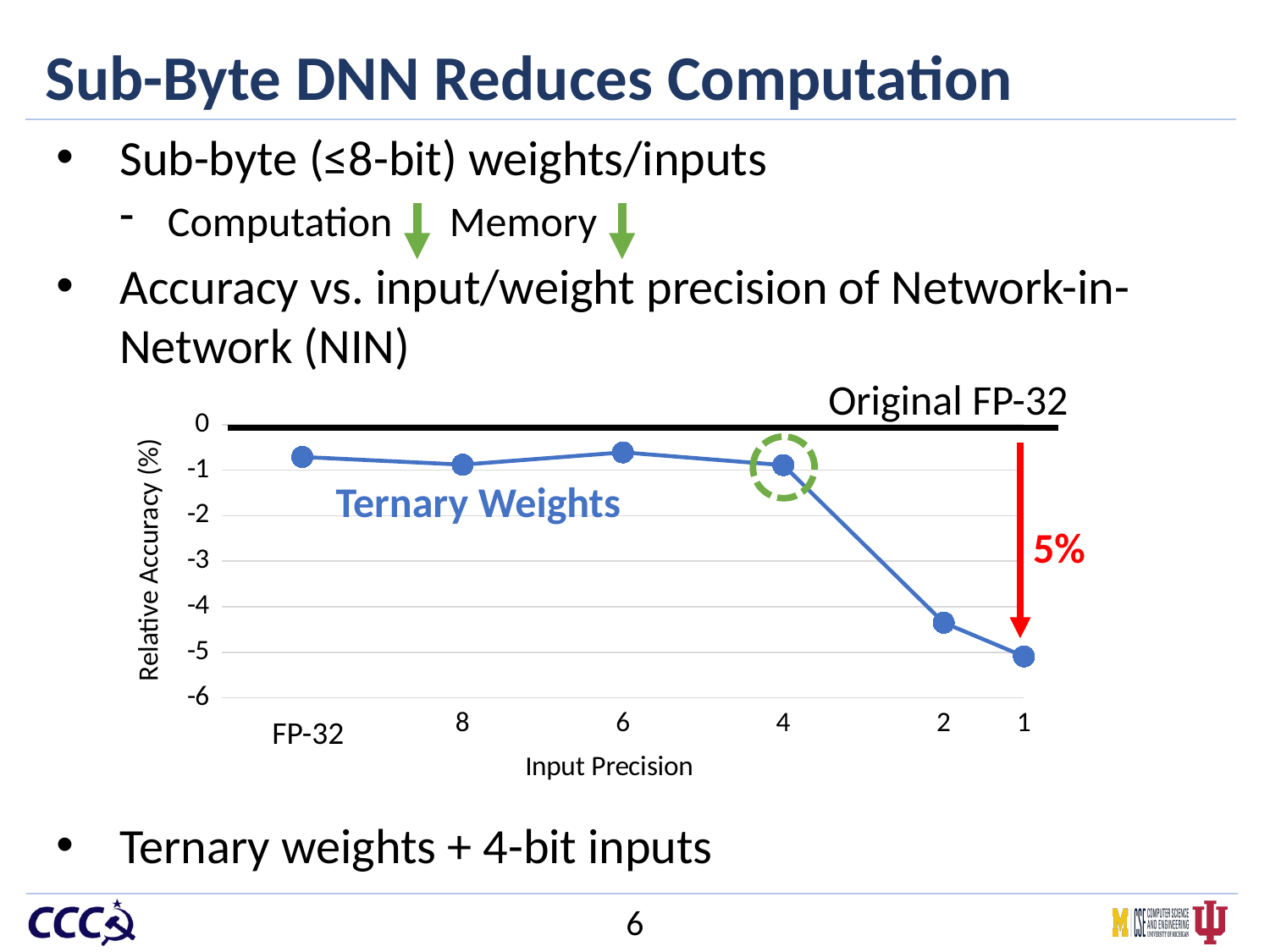
Is the relative accuracy at input precision 1 greater or less than -4? less What kind of chart is shown on the slide? line chart Is the relative accuracy at input precision 4 greater or less than -2? greater What is the title of the x axis? Input Precision How many data points are plotted on the line? 6 Is the relative accuracy at input precision 2 greater or less than -5? greater Does the relative accuracy rise or fall as the input precision goes from 4 to 1 along the x axis? fall Which has the higher relative accuracy, input precision 4 or input precision 2? 4 What is the title of the y axis? Relative Accuracy (%) Which input precision has the lowest relative accuracy? 1 Which has the higher relative accuracy, input precision 2 or input precision 1? 2